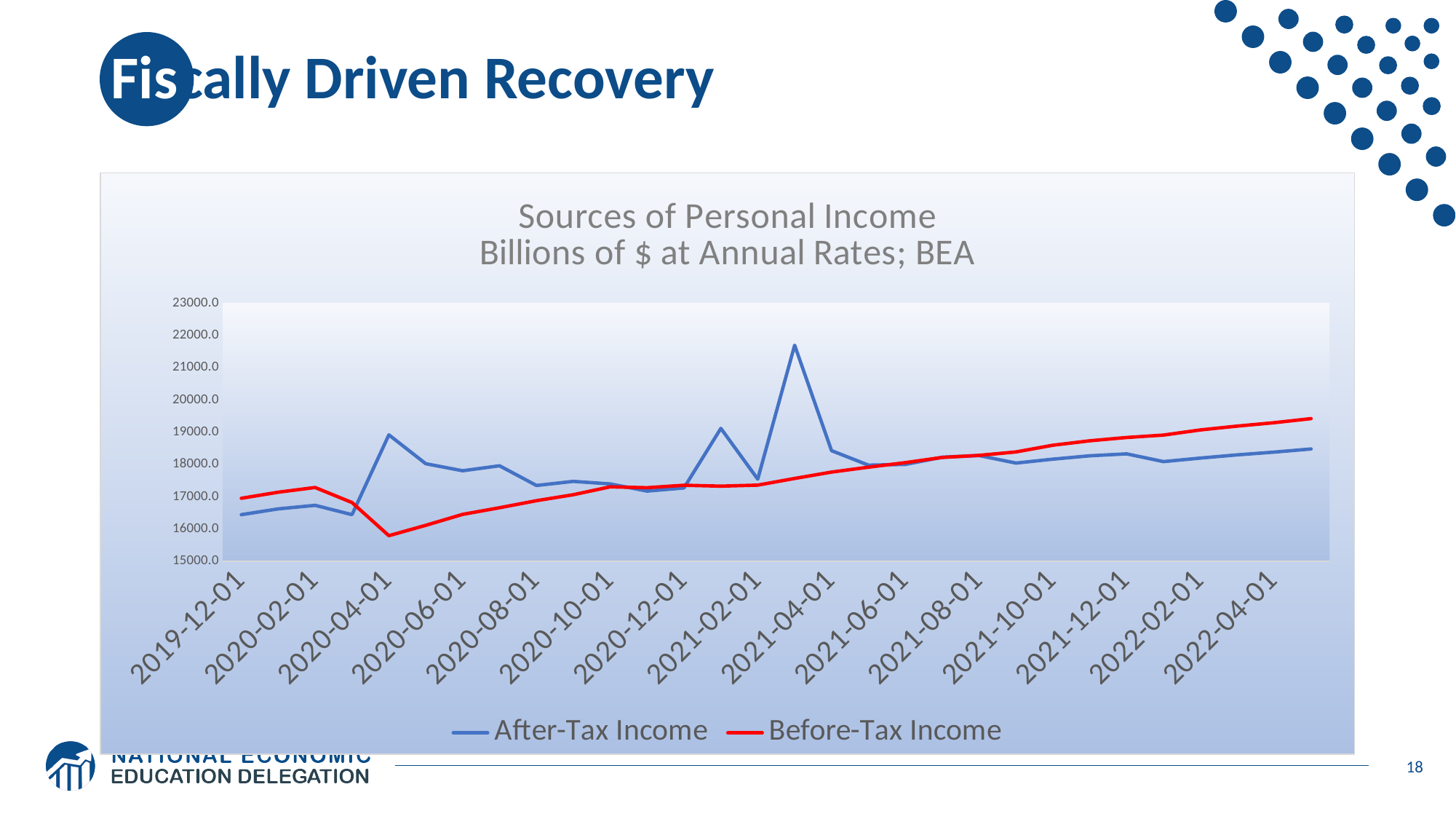
Which series reaches the highest value anywhere on the chart? After-Tax Income Is the value for After-Tax Income at 2020-04-01 greater or less than 17000.0? greater Is the value for Before-Tax Income at 2022-04-01 greater or less than 19000.0? greater Does the Before-Tax Income line rise or fall from 2020-04-01 to 2022-04-01? Rise What kind of chart is shown on the slide? Line chart At 2020-04-01, which series has the higher value, After-Tax Income or Before-Tax Income? After-Tax Income What is the title of the chart? Sources of Personal Income Billions of $ at Annual Rates; BEA How many series does the legend list? 2 At 2022-04-01, which series has the higher value, After-Tax Income or Before-Tax Income? Before-Tax Income Is the value for After-Tax Income at 2022-04-01 greater or less than 19000.0? less Which colour is used for the Before-Tax Income line? Red